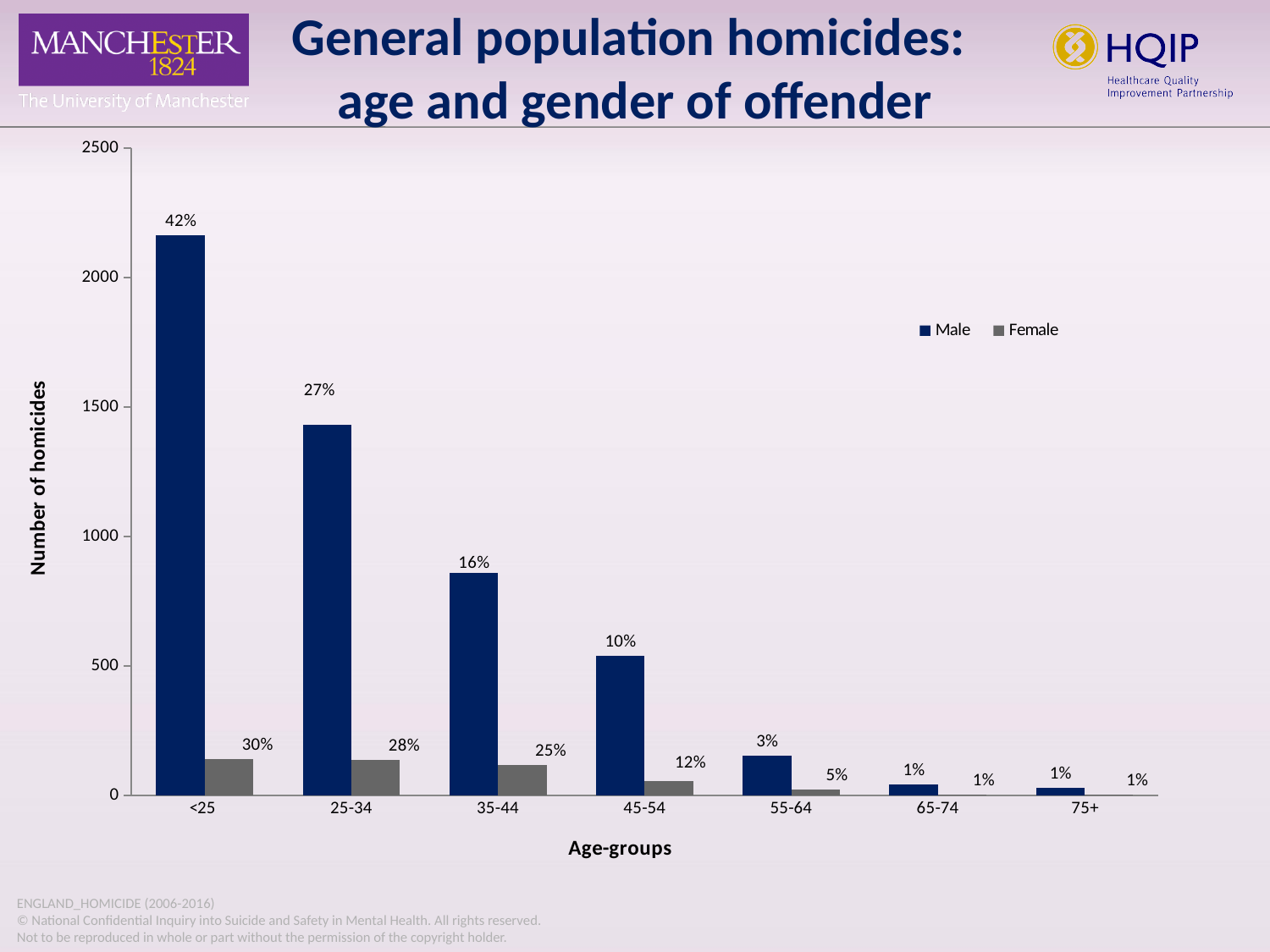
How many age-groups are shown on the x axis? 7 Is the number of homicides for Male offenders aged <25 greater or less than 2000? greater What is the difference in percentage points between the Male labels for <25 (42%) and 25-34 (27%)? 15 percentage points What kind of chart is shown on the slide? bar chart What percentage label is shown on the Male bar for the 45-54 age-group? 10% Which age-group has the highest Male bar? <25 What percentage label is shown on the Male bar for the <25 age-group? 42% What percentage label is shown on the Female bar for the 25-34 age-group? 28% How many series does the legend list? 2 Which is larger, the Male bar for 35-44 or the Male bar for 45-54? Male bar for 35-44 Is the number of homicides for Male offenders aged 25-34 greater or less than 1500? less